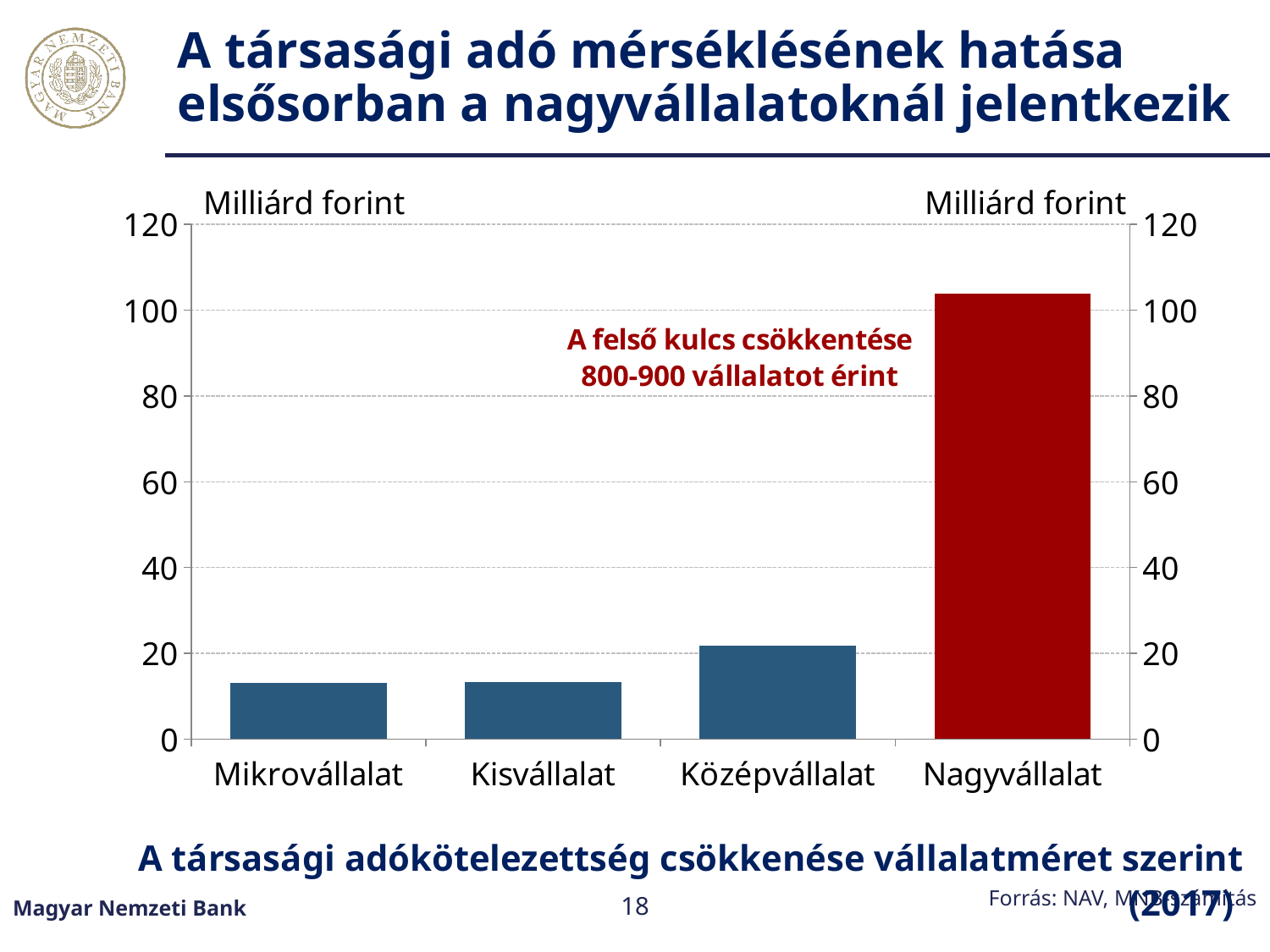
Is the value for Középvállalat greater or less than 20? greater How many categories are shown on the x axis of the chart? 4 What kind of chart is shown on the slide? bar chart Is the value for Nagyvállalat greater or less than 100? greater What unit is shown on the y axis of the chart? Milliárd forint Is the value for Mikrovállalat greater or less than 20? less Which category's bar is coloured dark red rather than blue? Nagyvállalat Which is larger, the value for Kisvállalat or the value for Középvállalat? Középvállalat Which is larger, the value for Középvállalat or the value for Nagyvállalat? Nagyvállalat Which category has the highest value in the chart? Nagyvállalat